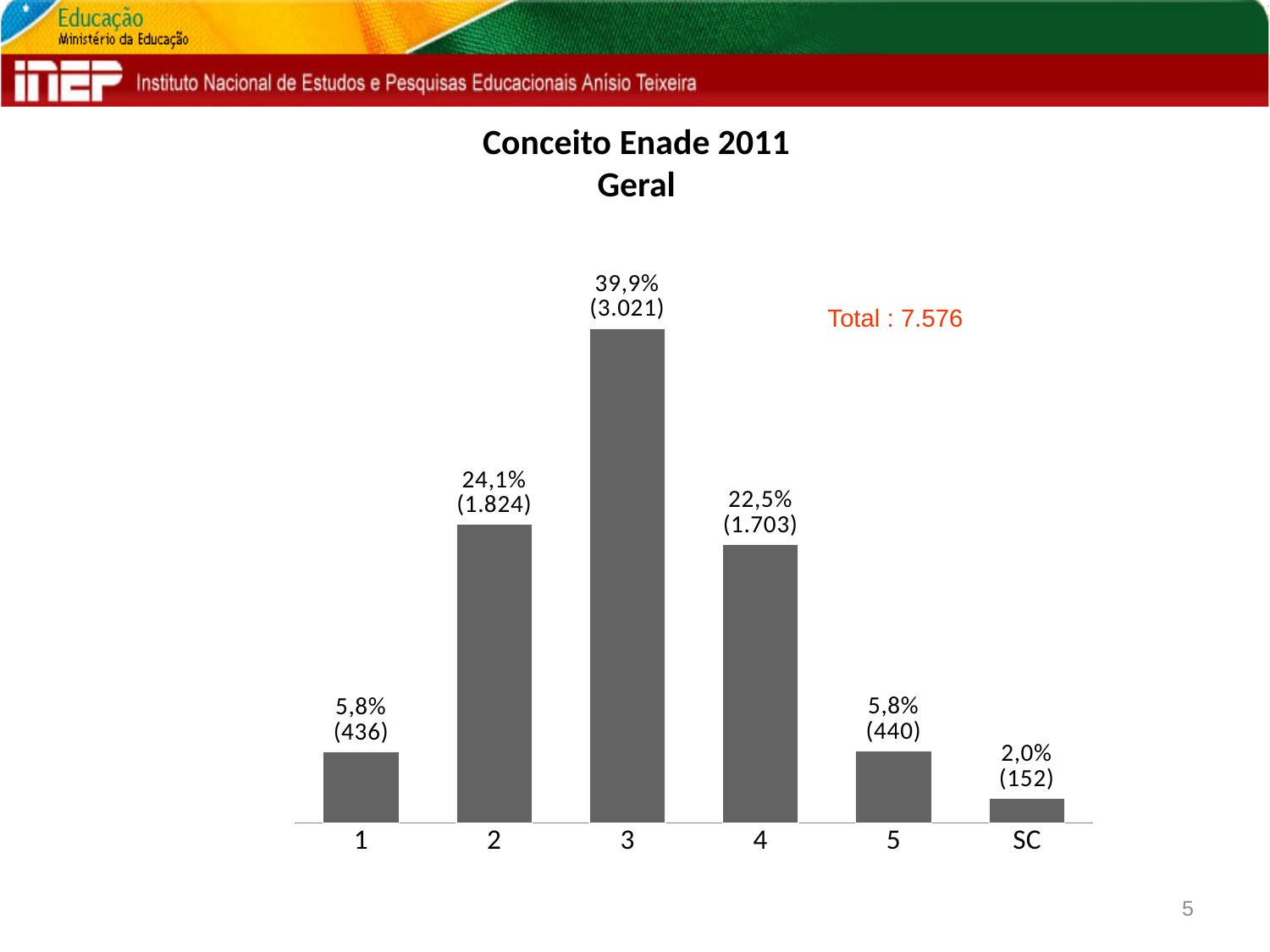
What is the difference in percentage points between category 3 and category 4? 17,4 What percentage is shown for the SC category? 2,0% How many categories are shown on the x axis? 6 How many institutions/courses are shown in parentheses for category 2? 1.824 Which has a larger count, category 2 or category 4? 2 Which category has the highest value? 3 Which category has the lowest value? SC What percentage is shown for category 3? 39,9% What is the difference between the counts for category 5 and category 1? 4 What total is stated on the slide? 7.576 What kind of chart is shown on the slide? bar chart What is the count shown in parentheses for category 4? 1.703